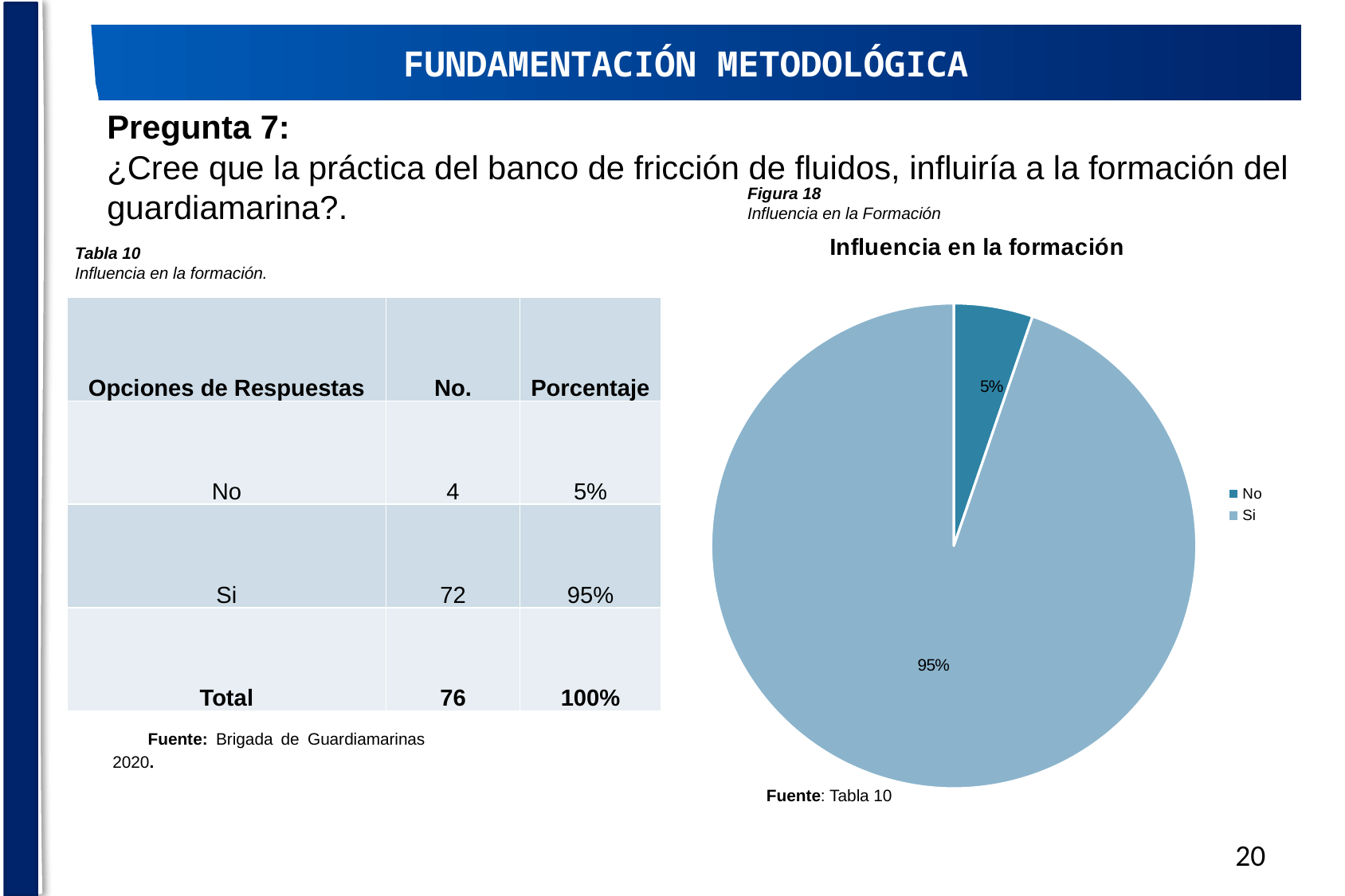
What percentage does the 'No' slice show in the pie chart? 5% Which category has the smallest slice in the pie chart? No What is the difference in percentage points between the 'Si' and 'No' slices? 90 What percentage does the 'Si' slice show in the pie chart? 95% What kind of chart is shown on the slide? pie chart Which category has the largest slice in the pie chart? Si What share of the pie does the 'No' slice represent? 5% Which slice is larger, 'Si' or 'No'? Si How many slices does the pie chart have? 2 How many entries does the legend of the pie chart list? 2 What is the title of the chart? Influencia en la formación Which legend entry is shown in the darker blue colour? No